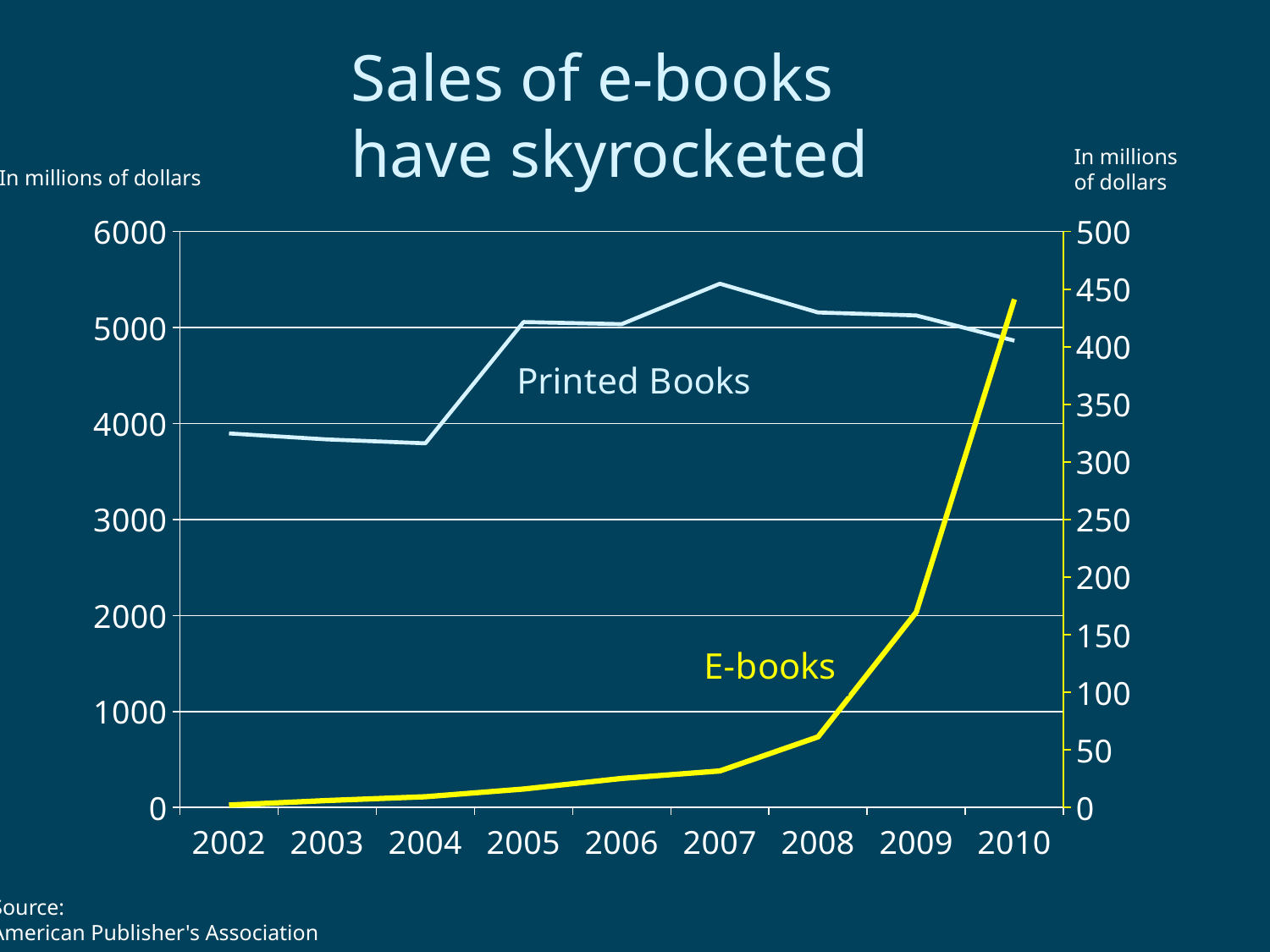
In which year are Printed Books sales highest? 2007 Do E-books sales rise or fall from 2002 to 2010? rise Which series is drawn in yellow? E-books How many years are plotted along the x axis? 9 How many data series are plotted on the chart? 2 In which year are E-books sales highest? 2010 What kind of chart is shown on the slide? line chart What is the title of the chart? Sales of e-books have skyrocketed In which year are E-books sales lowest? 2002 Is the value for Printed Books in 2007 greater or less than 5000? greater Is the value for E-books in 2010 greater or less than 400? greater Which is larger, Printed Books sales in 2007 or in 2010? 2007